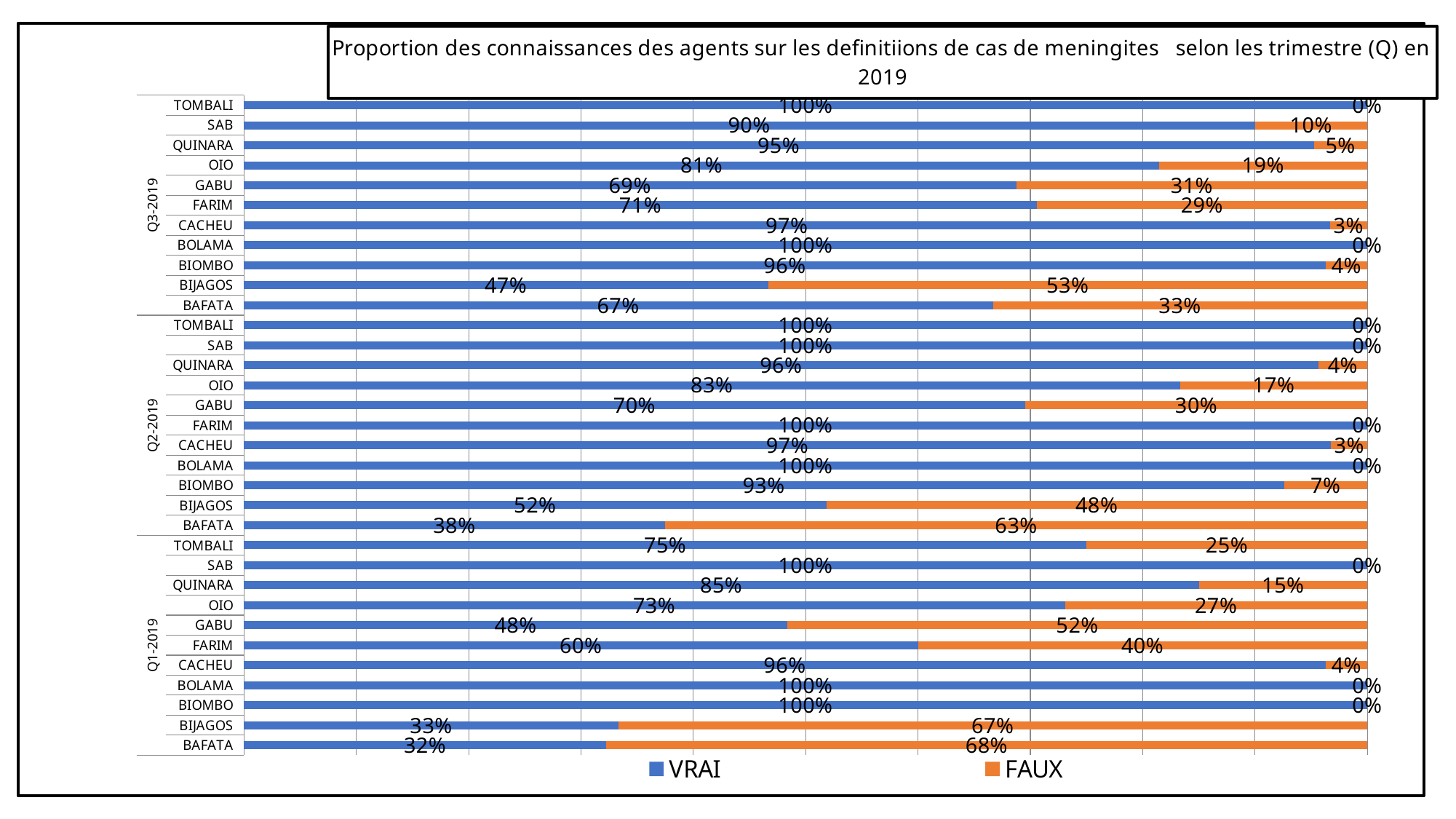
Which is larger, the VRAI value for GABU in Q2-2019 or the VRAI value for GABU in Q1-2019? GABU in Q2-2019 What is the VRAI value for BIJAGOS in Q3-2019? 47% Which colour represents the FAUX series in the chart? Orange What is the difference between the VRAI values for FARIM in Q3-2019 and FARIM in Q1-2019? 11% How many series does the legend list? 2 What is the VRAI value for OIO in Q2-2019? 83% What is the FAUX value for GABU in Q3-2019? 31% How many regions are listed within each quarter group? 11 Within Q2-2019, which region has the highest FAUX value? BAFATA What kind of chart is shown on the slide? Stacked bar chart What is the FAUX value for BAFATA in Q1-2019? 68% Within Q1-2019, which region has the lowest VRAI value? BAFATA